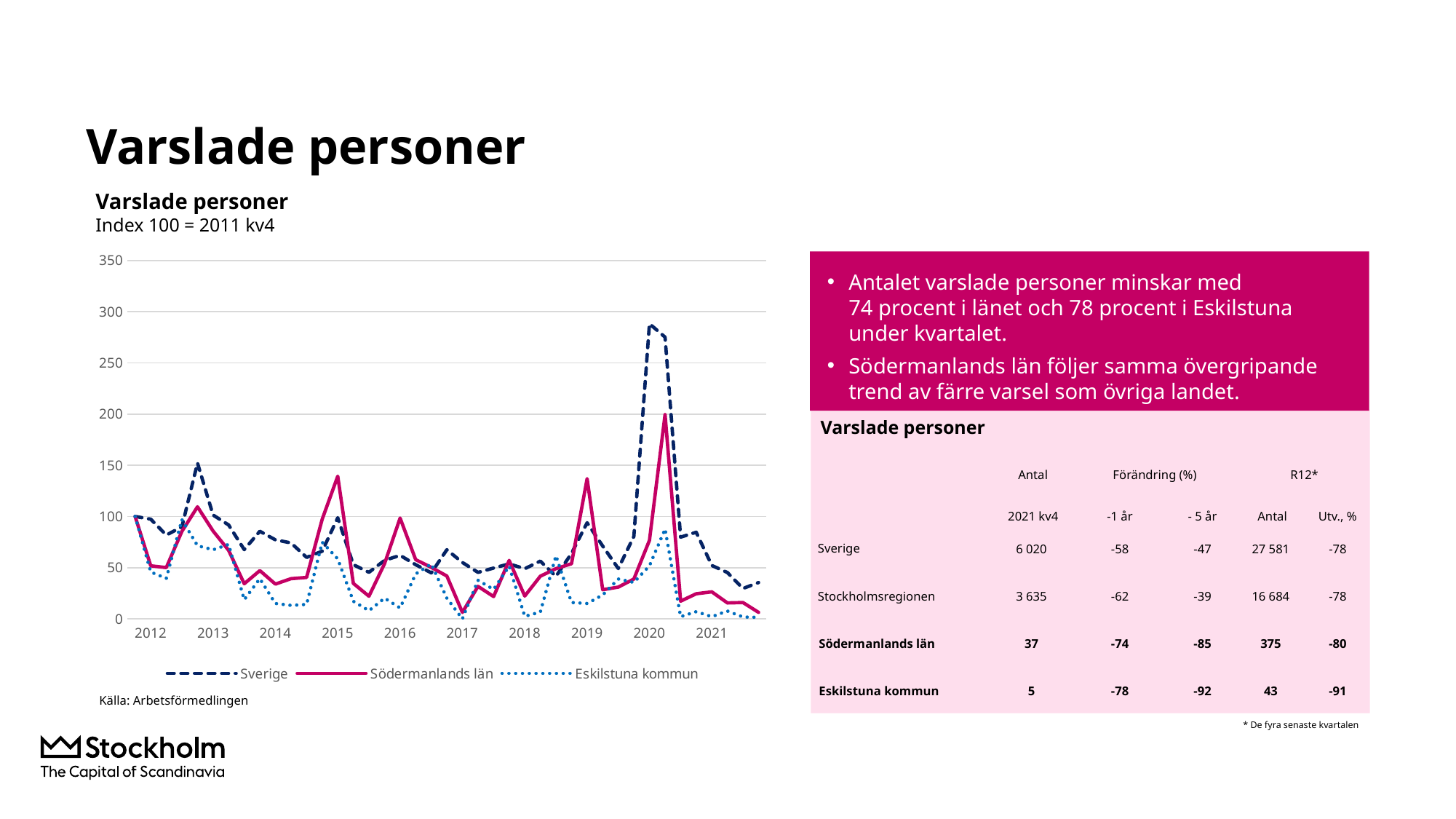
What kind of chart is shown on the slide? line chart What is the subtitle under the chart title 'Varslade personer'? Index 100 = 2011 kv4 Which series reaches the highest peak in the chart? Sverige Is the peak value for Södermanlands län in 2020 greater or less than 150? greater How many series does the chart legend list? 3 Do the values for Södermanlands län rise or fall from the 2020 peak to the end of 2021? fall In which year does the Sverige series reach its highest value? 2020 Is the peak value for Eskilstuna kommun in 2020 greater or less than 100? less At the 2020 peak, which series is higher: Sverige or Eskilstuna kommun? Sverige How many year labels are shown on the x axis? 10 Which series are listed in the chart legend? Sverige, Södermanlands län, Eskilstuna kommun Is the peak value for Sverige in 2020 greater or less than 250? greater